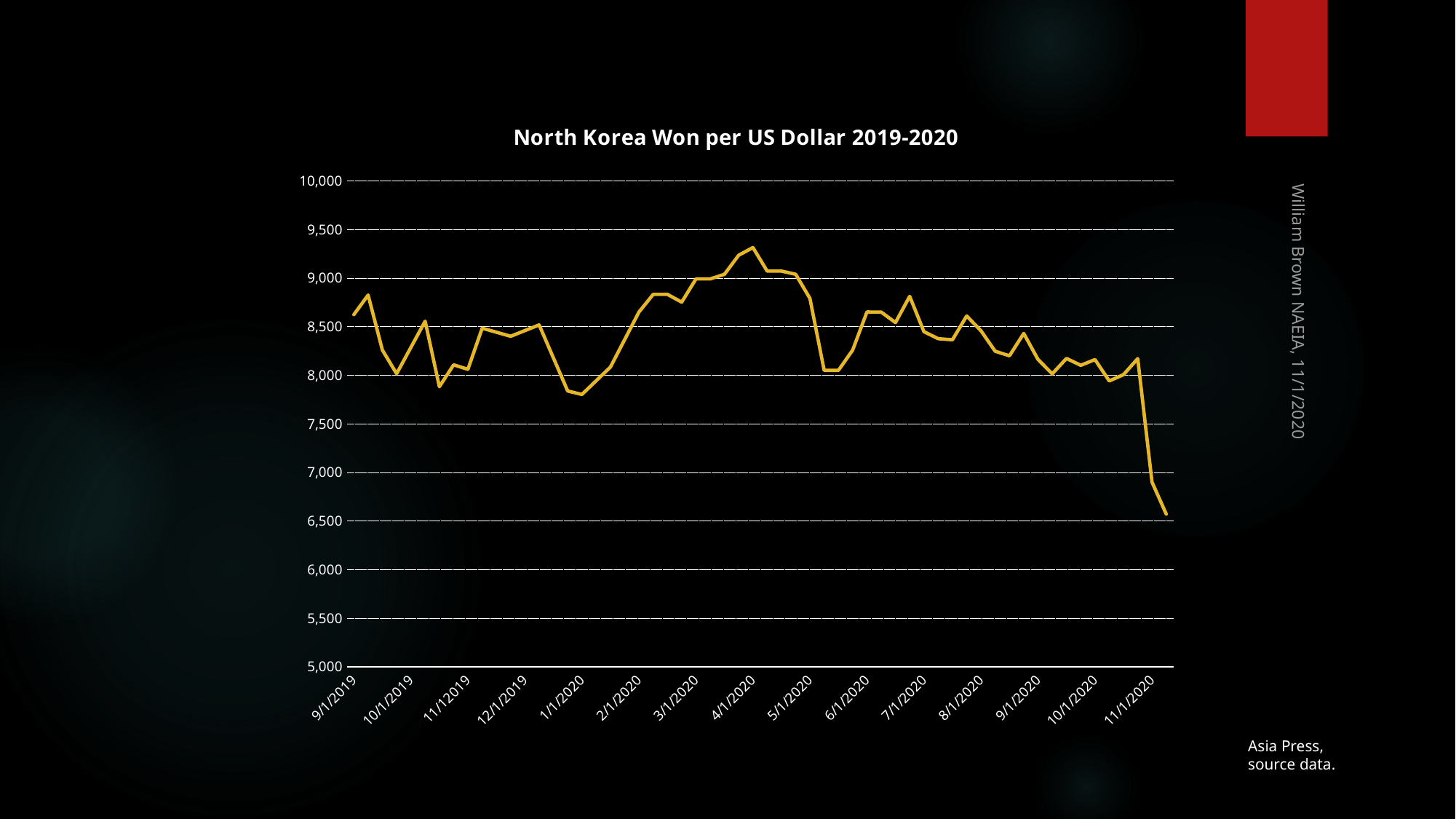
Is the value at 4/1/2020 greater or less than 8,500? greater Is the value at 11/1/2020 greater or less than 8,500? less Overall, does the value rise or fall from 9/1/2019 to the end of the series? fall What is the title of the chart? North Korea Won per US Dollar 2019-2020 Which is larger, the value at 9/1/2019 or the value at 11/1/2020? 9/1/2019 Which is larger, the value at 4/1/2020 or the value at 1/1/2020? 4/1/2020 Is the value at 1/1/2020 greater or less than 8,000? less Between 1/1/2020 and 4/1/2020, does the line rise or fall? rise How many date labels are shown along the x axis? 15 What kind of chart is shown on the slide? line chart